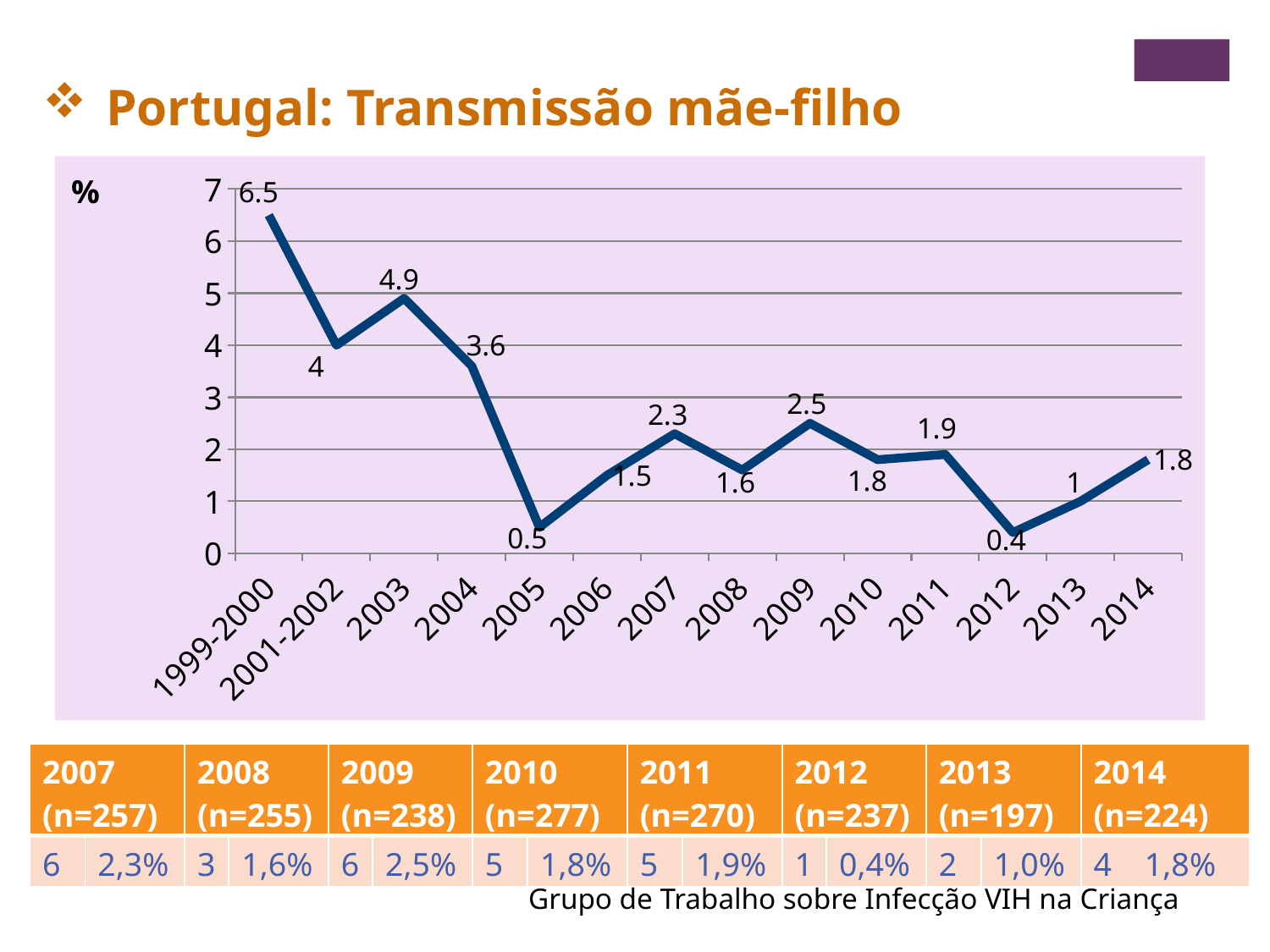
Which is larger, the value for 2007 or the value for 2008? 2007 What is the value for 2013? 1 Which category has the lowest value? 2012 How many categories are plotted on the x axis? 14 Which category has the highest value? 1999-2000 What is the value for 2009? 2.5 What type of chart is shown on the slide? line chart What is the value for 2005? 0.5 What is the difference between the values for 2003 and 2004? 1.3 What is the value for 1999-2000? 6.5 What unit is indicated on the y axis of the chart? % Do the values generally rise or fall from 1999-2000 to 2014? fall